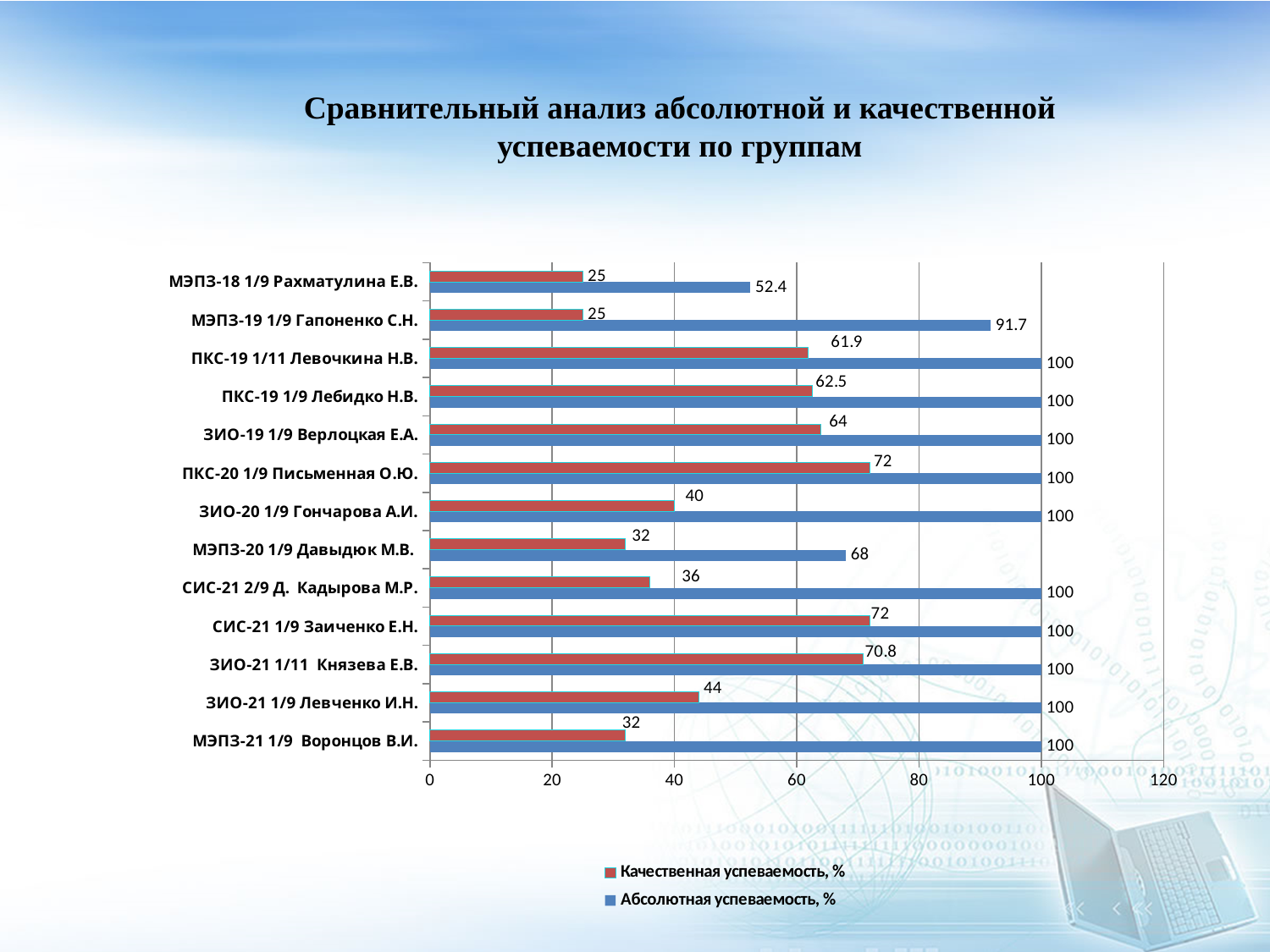
Which group has the lowest value of Абсолютная успеваемость, %? МЭПЗ-18 1/9 Рахматулина Е.В. What is the value of Качественная успеваемость, % for ЗИО-21 1/11 Князева Е.В.? 70.8 What type of chart is shown on the slide? Bar chart What is the value of Качественная успеваемость, % for ЗИО-20 1/9 Гончарова А.И.? 40 What is the value of Абсолютная успеваемость, % for МЭПЗ-20 1/9 Давыдюк М.В.? 68 How many groups are shown on the chart? 13 Which has a higher Качественная успеваемость, %: ПКС-19 1/9 Лебидко Н.В. or СИС-21 2/9 Д. Кадырова М.Р.? ПКС-19 1/9 Лебидко Н.В. What is the value of Абсолютная успеваемость, % for МЭПЗ-19 1/9 Гапоненко С.Н.? 91.7 How many series does the legend list? 2 What is the difference in Качественная успеваемость, % between ПКС-20 1/9 Письменная О.Ю. and ЗИО-21 1/9 Левченко И.Н.? 28 Is the value of Качественная успеваемость, % for ЗИО-19 1/9 Верлоцкая Е.А. greater or less than 60? greater What is the difference between Абсолютная успеваемость, % and Качественная успеваемость, % for МЭПЗ-18 1/9 Рахматулина Е.В.? 27.4